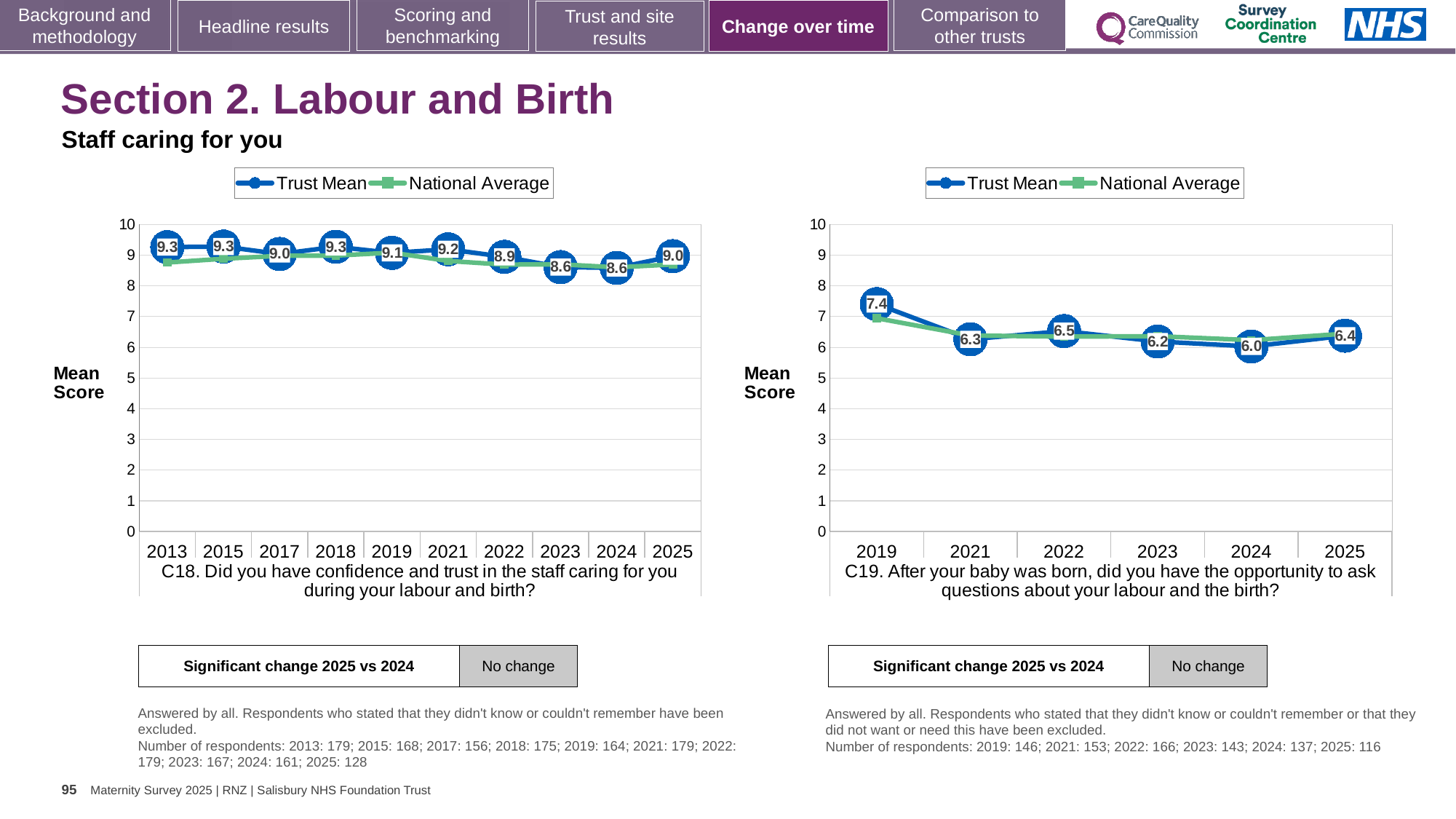
In the C19 chart, what is the difference between the Trust Mean scores for 2019 and 2025? 1.0 In the C18 chart, what is the difference between the Trust Mean scores for 2013 and 2024? 0.7 In the C19 chart, what is the Trust Mean score for 2019? 7.4 In the C18 chart, is the Trust Mean score for 2021 higher or lower than for 2022? higher How many years are plotted on the x axis of the C18 chart? 10 In the C18 chart, what is the Trust Mean score for 2025? 9.0 In the C19 chart, which year has the lowest Trust Mean score? 2024 In the C19 chart, which year has the highest Trust Mean score? 2019 What type of chart is used for the C19 question? line chart How many series does the legend of the C19 chart list? 2 In the C19 chart, what is the Trust Mean score for 2024? 6.0 In the C18 chart, what is the Trust Mean score for 2023? 8.6